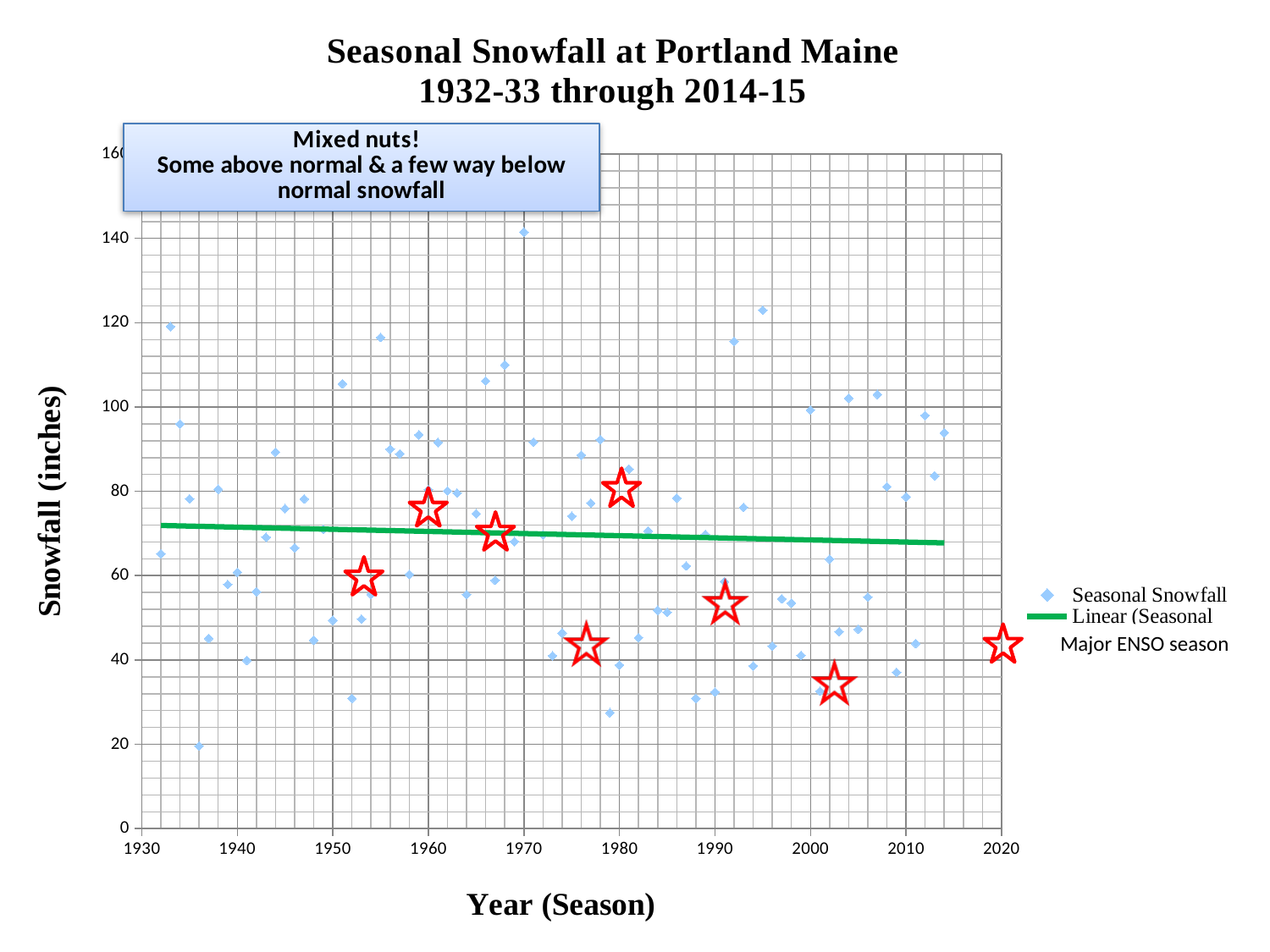
How many red star markers for Major ENSO seasons are plotted on the chart? 8 Is the highest plotted seasonal snowfall value greater or less than 120 inches? greater What is the label of the vertical axis? Snowfall (inches) How many entries does the chart legend list? 3 What kind of chart is shown on the slide? Scatter chart Is the seasonal snowfall value plotted at 1980 greater or less than 60 inches? less What is the title of the chart? Seasonal Snowfall at Portland Maine 1932-33 through 2014-15 Is the seasonal snowfall value plotted at 2000 greater or less than 80 inches? greater Does the green linear trend line rise or fall from left to right across the years? Fall Which is larger, the seasonal snowfall plotted at 1970 or the seasonal snowfall plotted at 1980? 1970